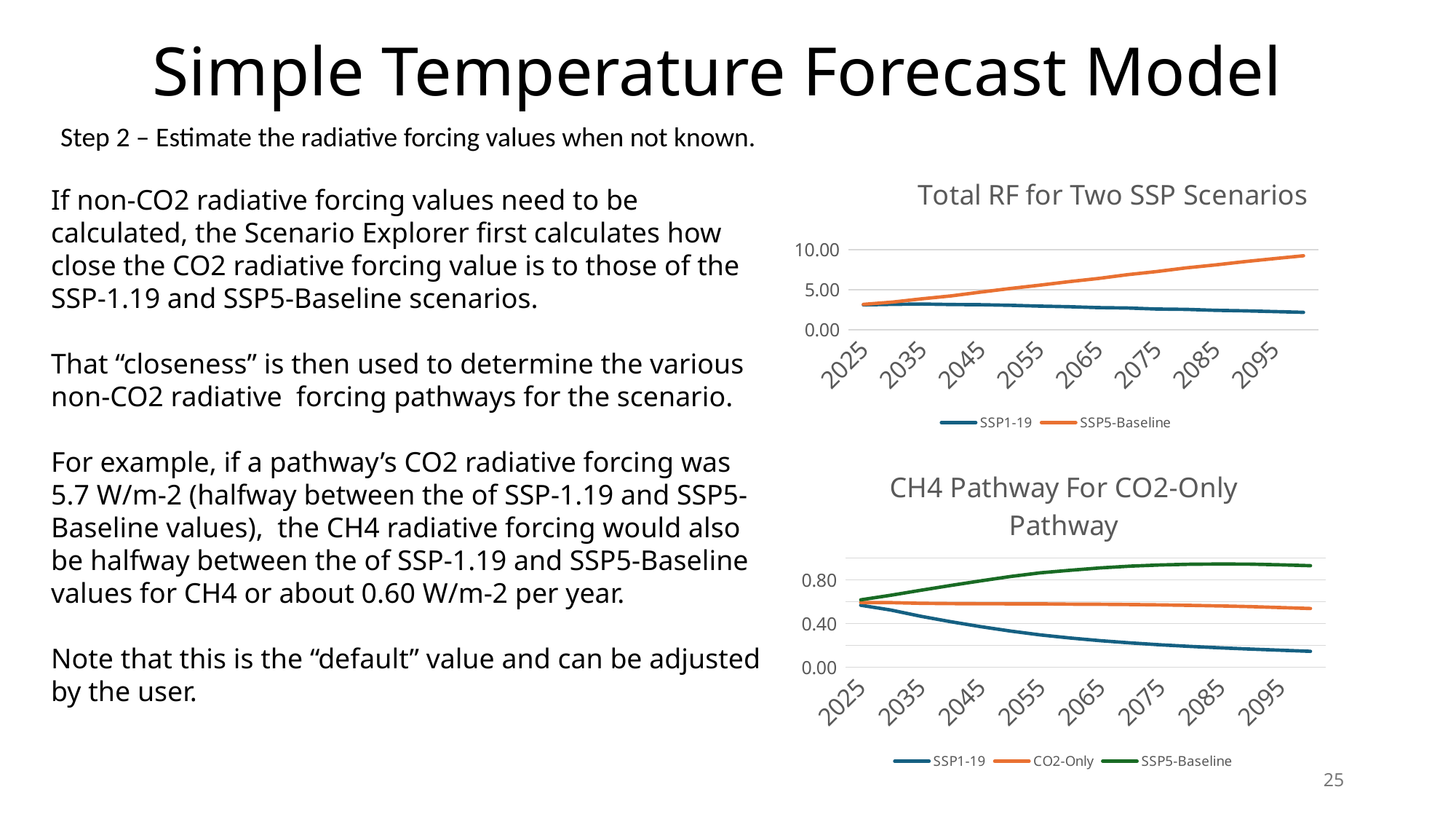
In the "CH4 Pathway For CO2-Only Pathway" chart, is the SSP1-19 value at 2095 greater or less than 0.40? less In the "Total RF for Two SSP Scenarios" chart, does the SSP5-Baseline series rise or fall from 2025 to 2095? rise How many series does the legend of the "Total RF for Two SSP Scenarios" chart list? 2 In the "CH4 Pathway For CO2-Only Pathway" chart, does the SSP1-19 series rise or fall from 2025 to 2095? fall In the "CH4 Pathway For CO2-Only Pathway" chart, is the SSP5-Baseline value at 2085 greater or less than 0.80? greater In the "Total RF for Two SSP Scenarios" chart, is the SSP1-19 value at 2095 greater or less than 5.00? less In the "Total RF for Two SSP Scenarios" chart, which series has the larger value at 2095, SSP1-19 or SSP5-Baseline? SSP5-Baseline What is the title of the lower chart on the slide? CH4 Pathway For CO2-Only Pathway What kind of chart is the "Total RF for Two SSP Scenarios" chart? line chart In the "CH4 Pathway For CO2-Only Pathway" chart, which series has the larger value at 2095, SSP1-19 or SSP5-Baseline? SSP5-Baseline How many series does the legend of the "CH4 Pathway For CO2-Only Pathway" chart list? 3